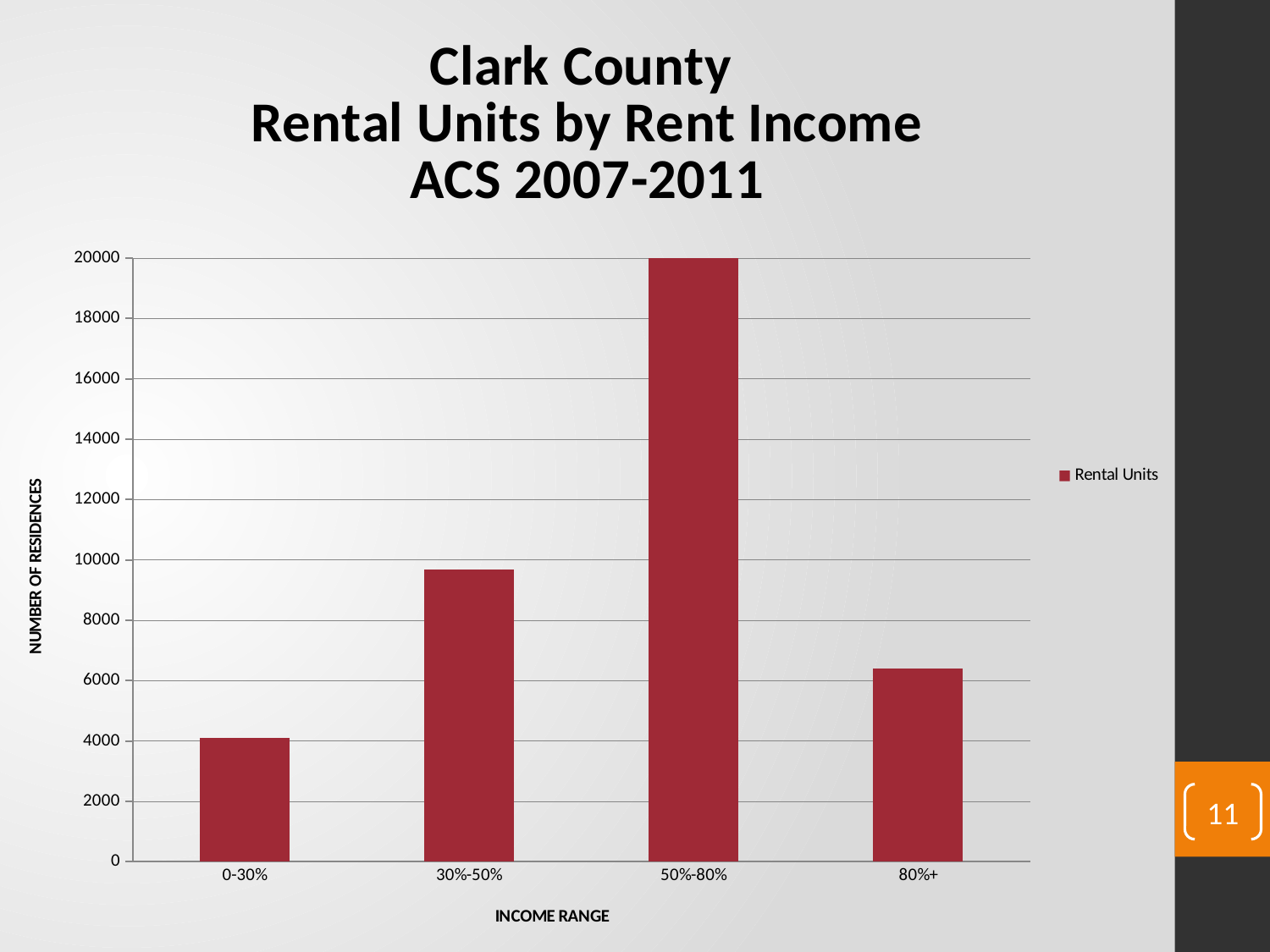
What kind of chart is shown on the slide? bar chart Which has more rental units, the 0-30% range or the 80%+ range? 80%+ Which income range has the highest number of rental units? 50%-80% Is the value for 30%-50% greater or less than 8000? greater Is the value for 80%+ greater or less than 8000? less Is the value for 50%-80% greater or less than 18000? greater How many income range categories are shown on the x axis? 4 How many series does the legend list? 1 What is the label of the y axis? NUMBER OF RESIDENCES Which has more rental units, the 30%-50% range or the 80%+ range? 30%-50% Which income range has the lowest number of rental units? 0-30%